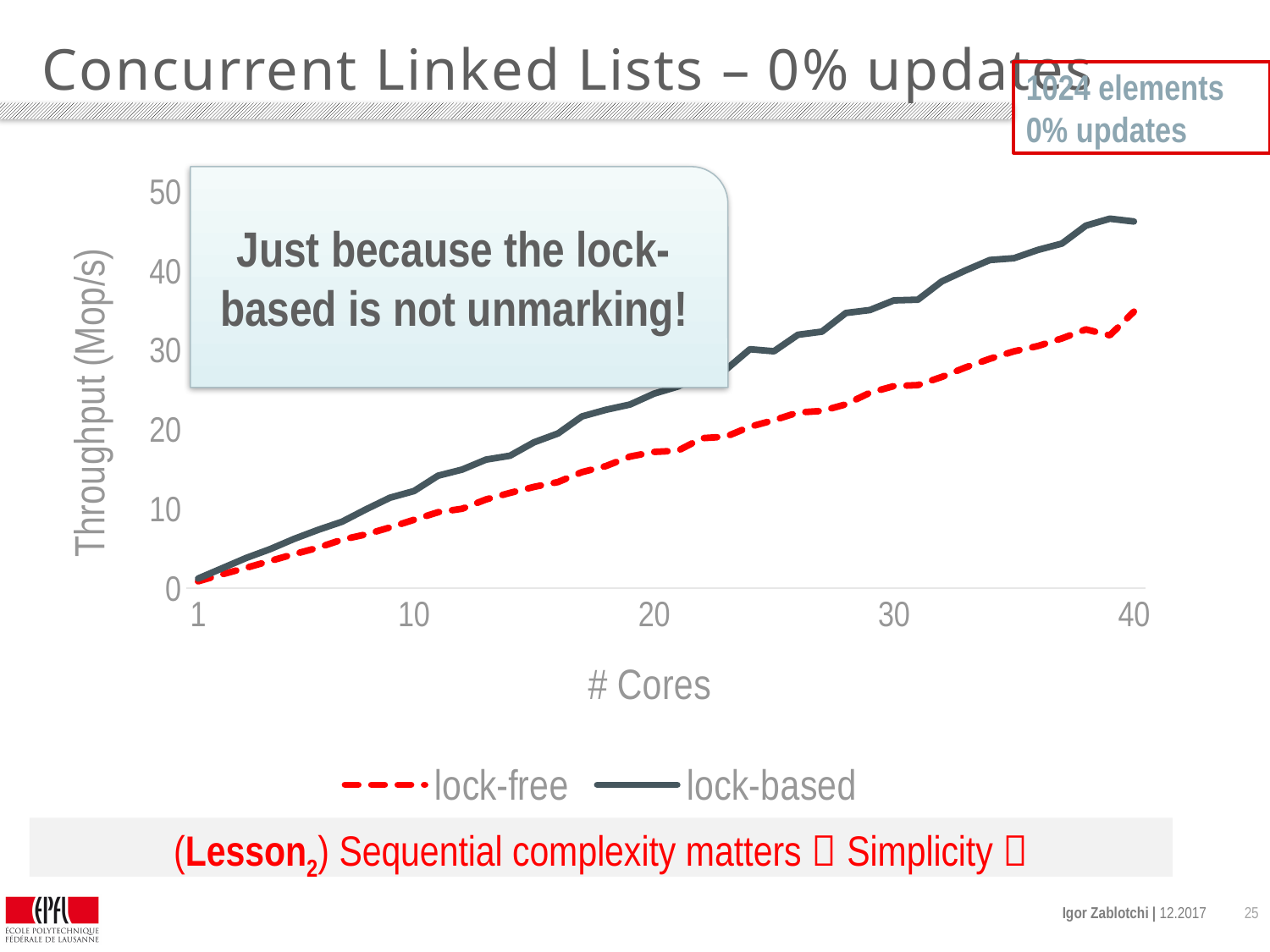
Does the throughput of the lock-free series rise or fall as the number of cores increases? rise Is the throughput of the lock-free series at 40 cores greater or less than 40? less How many series does the legend list? 2 Is the throughput of the lock-based series at 40 cores greater or less than 40? greater Does the throughput of the lock-based series rise or fall as the number of cores increases? rise At 40 cores, which series has the higher throughput, lock-free or lock-based? lock-based Is the throughput of the lock-based series at 20 cores greater or less than 20? greater Which series is drawn with a red dashed line? lock-free What is the label of the y axis? Throughput (Mop/s) At 30 cores, which series has the higher throughput, lock-free or lock-based? lock-based What kind of chart is shown on the slide? line chart